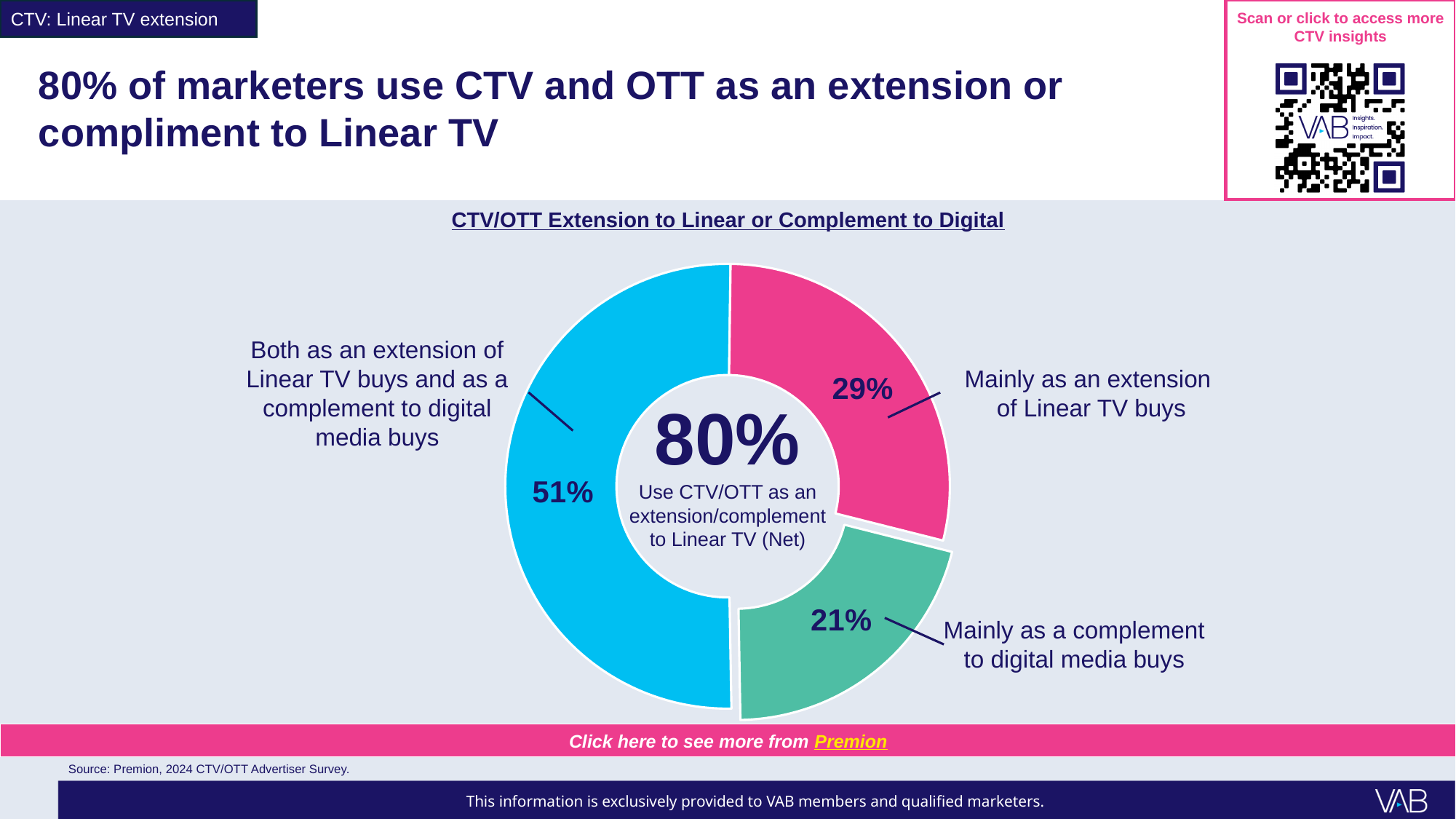
What is the difference in percentage points between 'Mainly as an extension of Linear TV buys' and 'Mainly as a complement to digital media buys'? 8 What percentage of marketers use CTV/OTT mainly as an extension of Linear TV buys? 29% Which category has the largest share of the chart? Both as an extension of Linear TV buys and as a complement to digital media buys What is the title of the chart? CTV/OTT Extension to Linear or Complement to Digital How many categories are shown in the chart? 3 What net percentage shown in the centre of the chart use CTV/OTT as an extension/complement to Linear TV? 80% What kind of chart is shown on the slide? Pie chart (donut) What is the difference in percentage points between the 'Both' category and 'Mainly as an extension of Linear TV buys'? 22 Which is larger: the share for 'Mainly as an extension of Linear TV buys' or 'Mainly as a complement to digital media buys'? Mainly as an extension of Linear TV buys Which category has the smallest share of the chart? Mainly as a complement to digital media buys What percentage of marketers use CTV/OTT both as an extension of Linear TV buys and as a complement to digital media buys? 51% What percentage of marketers use CTV/OTT mainly as a complement to digital media buys? 21%